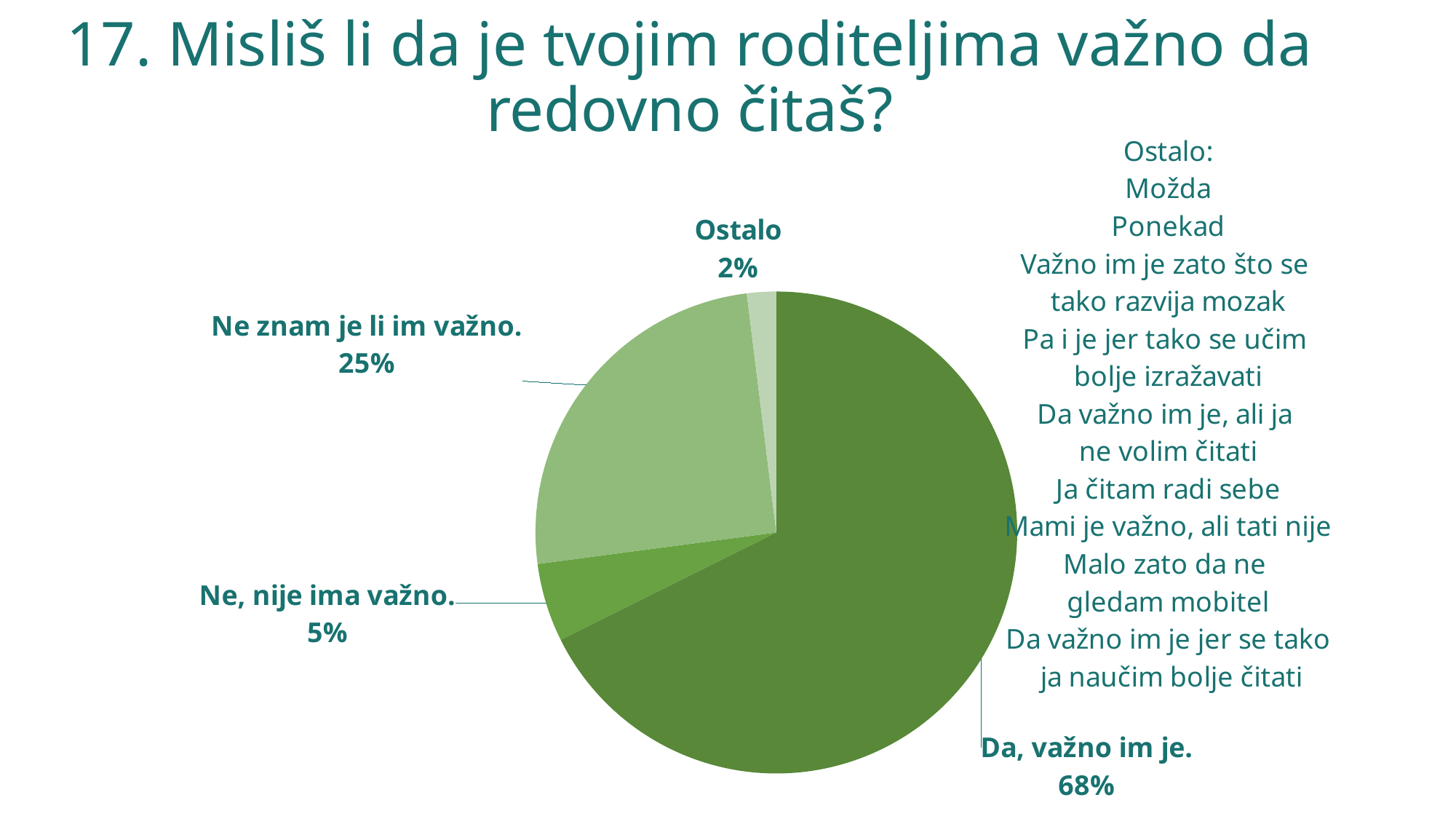
Which is larger, the share for "Ne znam je li im važno." or the share for "Ne, nije ima važno."? Ne znam je li im važno. What is the value for "Ne, nije ima važno."? 5% How many slices does the pie chart have? 4 Which category has the largest slice of the pie? Da, važno im je. What kind of chart is shown on the slide? pie chart What is the difference between the shares of "Da, važno im je." and "Ne znam je li im važno."? 43% What is the value for "Ostalo"? 2% What is the title of the slide containing the pie chart? 17. Misliš li da je tvojim roditeljima važno da redovno čitaš? What is the difference between the shares of "Ne, nije ima važno." and "Ostalo"? 3% What share of the pie does "Ne znam je li im važno." have? 25% What share of the pie does "Da, važno im je." have? 68% Which category has the smallest slice of the pie? Ostalo